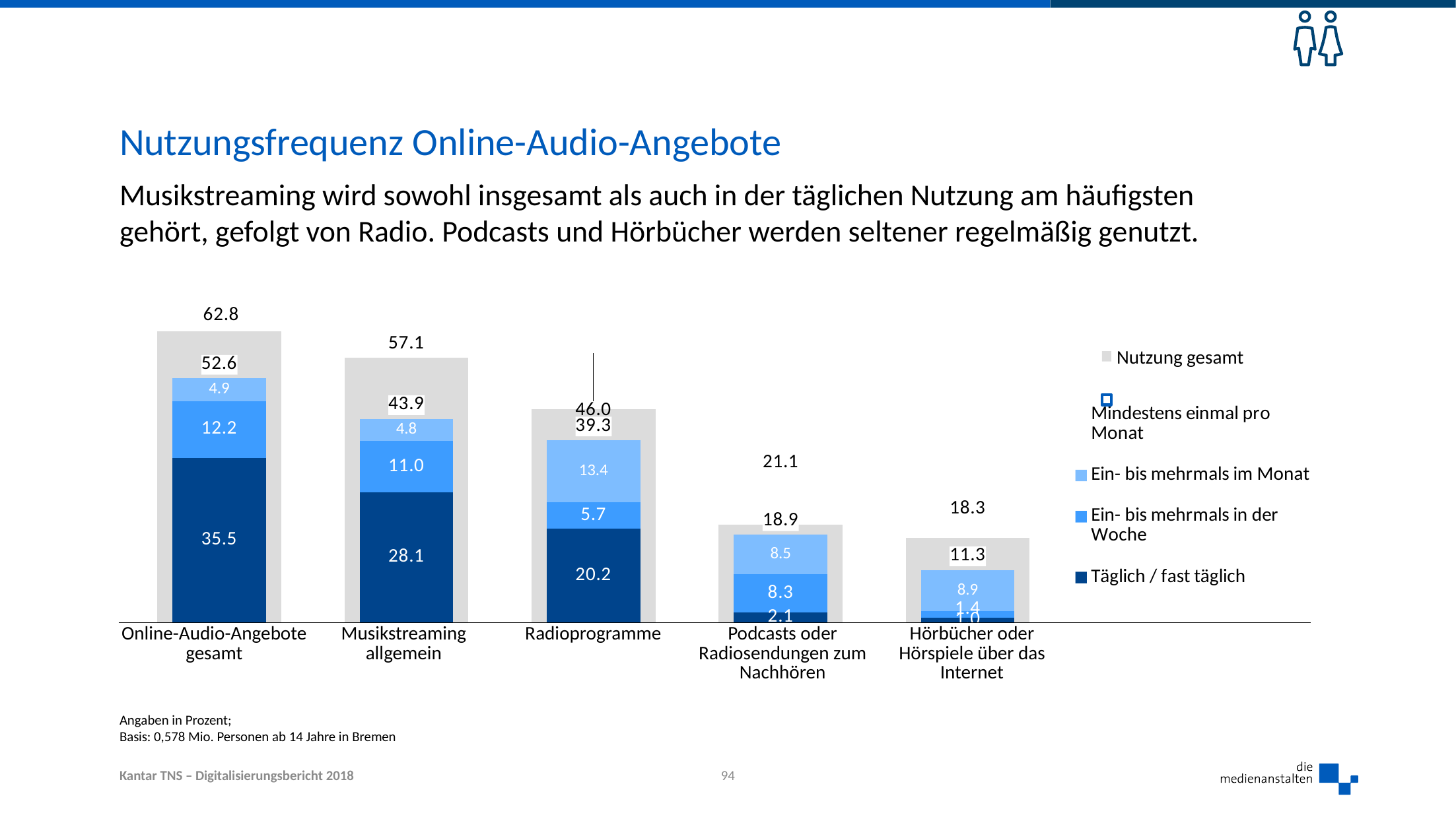
Which is larger: the 'Ein- bis mehrmals in der Woche' value for Musikstreaming allgemein or for Radioprogramme? Musikstreaming allgemein How many series does the legend list? 5 How many categories are shown on the x axis of the chart? 5 What type of chart is shown on the slide? stacked bar chart What is the difference between the 'Nutzung gesamt' values for Online-Audio-Angebote gesamt and Musikstreaming allgemein? 5.7 Which category has the lowest 'Täglich / fast täglich' value? Hörbücher oder Hörspiele über das Internet Which category has the highest 'Nutzung gesamt' value? Online-Audio-Angebote gesamt What is the 'Ein- bis mehrmals im Monat' value for Podcasts oder Radiosendungen zum Nachhören? 8.5 What is the 'Täglich / fast täglich' value for Radioprogramme? 20.2 What is the 'Nutzung gesamt' value for Musikstreaming allgemein? 57.1 What is the title of the chart slide? Nutzungsfrequenz Online-Audio-Angebote What is the 'Mindestens einmal pro Monat' value for Hörbücher oder Hörspiele über das Internet? 11.3